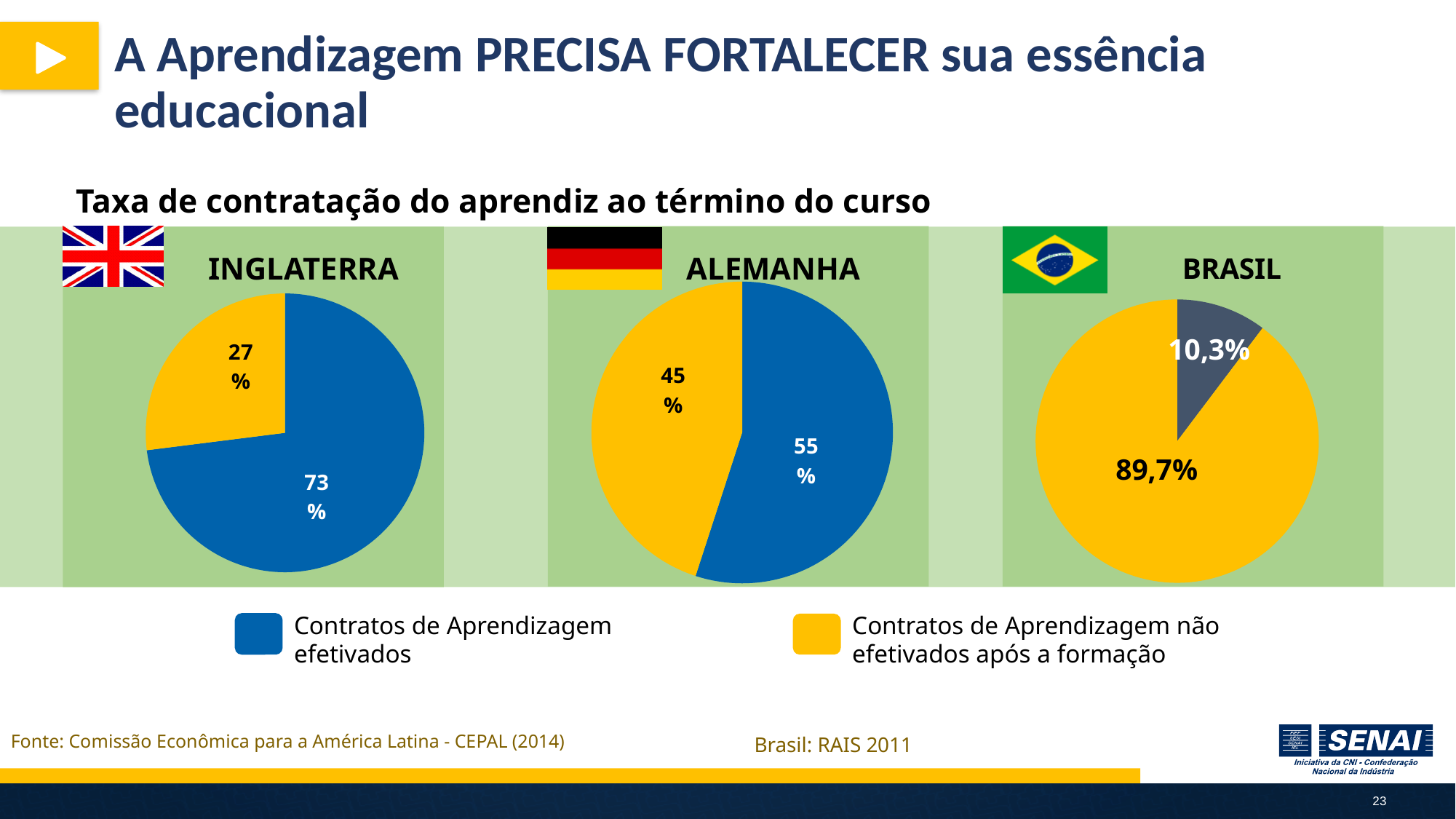
Which country's pie chart shows the highest share of Contratos de Aprendizagem efetivados? INGLATERRA What type of chart is used for each country on the slide? Pie chart What is the difference between the two slices in the INGLATERRA pie chart? 46% In the ALEMANHA pie chart, what share is shown for Contratos de Aprendizagem efetivados? 55% In the INGLATERRA pie chart, what share is shown for Contratos de Aprendizagem não efetivados após a formação? 27% How many entries does the legend below the pie charts list? 2 In the INGLATERRA pie chart, what share is shown for Contratos de Aprendizagem efetivados? 73% In the ALEMANHA pie chart, what share is shown for Contratos de Aprendizagem não efetivados após a formação? 45% In the BRASIL pie chart, what is the value of the large yellow slice? 89,7% Which country's pie chart shows the largest share of Contratos de Aprendizagem não efetivados após a formação? BRASIL In the BRASIL pie chart, what is the value of the small slice? 10,3% How many pie charts are shown on the slide? 3